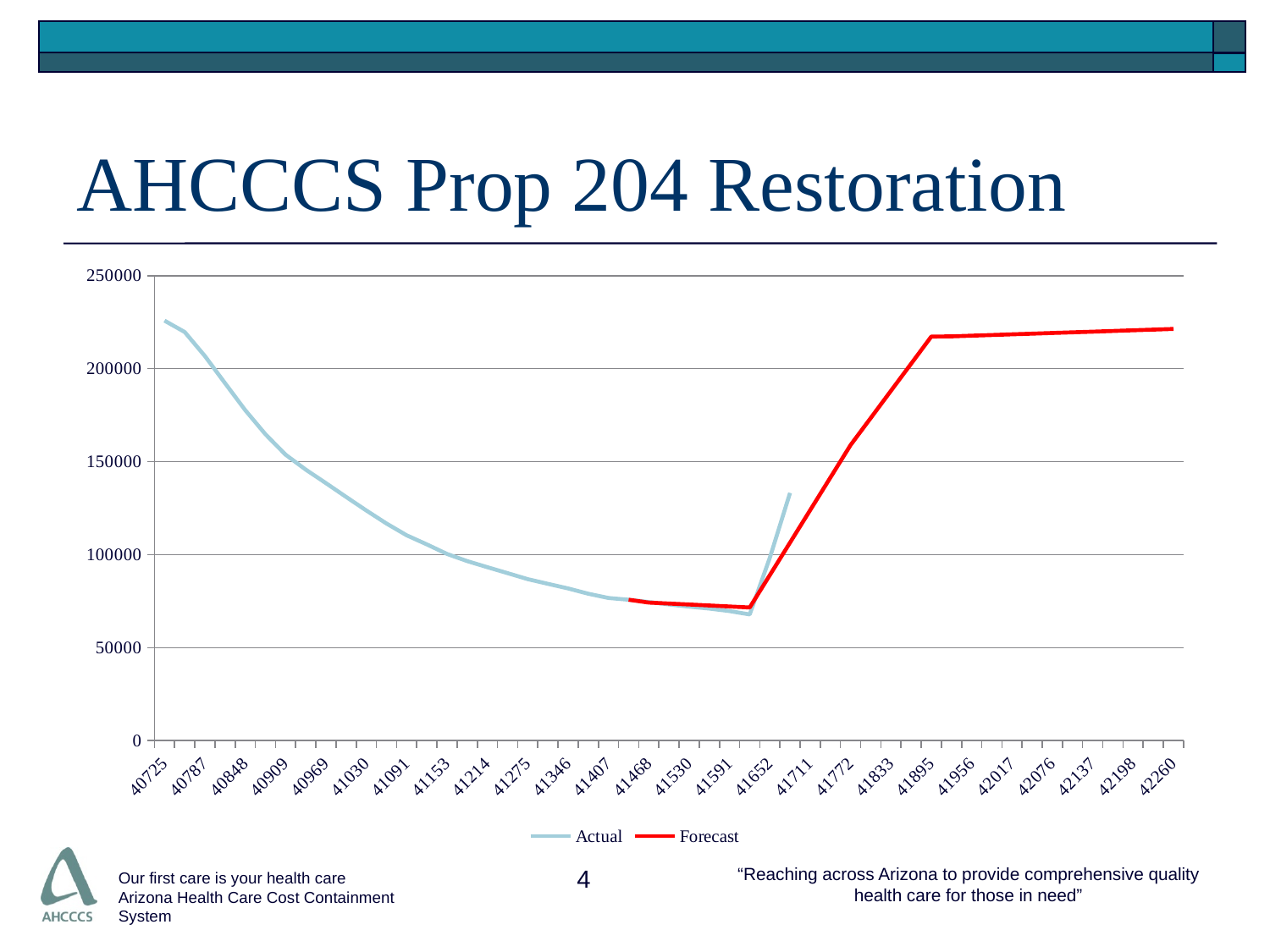
How many series does the legend list? 2 What is the title of the slide containing the chart? AHCCCS Prop 204 Restoration Is the Forecast value at 41895 greater or less than 200000? greater Does the Actual series rise or fall between 40725 and 41591? fall Does the Forecast series rise or fall between 41652 and 41895? rise How many labels are shown on the x axis? 26 Is the Actual value at 41591 greater or less than 100000? less What kind of chart is shown on the slide? line chart Is the Forecast value at 41468 greater or less than 100000? less What are the two series named in the legend? Actual and Forecast